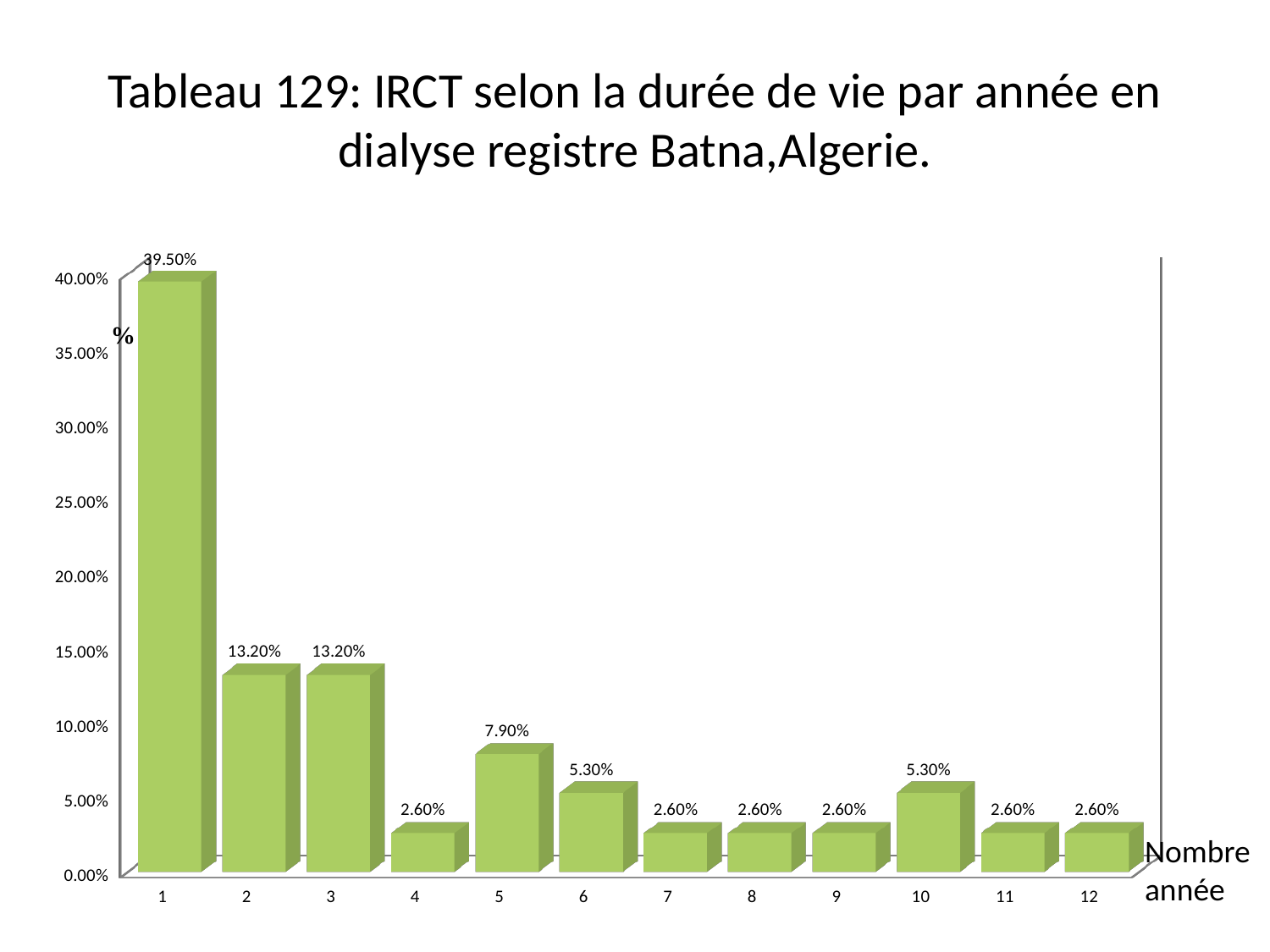
What is the difference between the values for year 5 and year 6? 2.60% What is the value for year 1? 39.50% What is the difference between the values for year 1 and year 2? 26.30% What is the title of the chart? Tableau 129: IRCT selon la durée de vie par année en dialyse registre Batna,Algerie. Which is larger, the value for year 6 or the value for year 7? year 6 What kind of chart is shown on the slide? bar chart How many years (categories) are shown on the x axis? 12 Is the value for year 1 greater or less than 35.00%? greater What is the value for year 10? 5.30% What is the value for year 5? 7.90% Which year has the highest value? 1 Do the values generally rise or fall from year 1 to year 4? fall